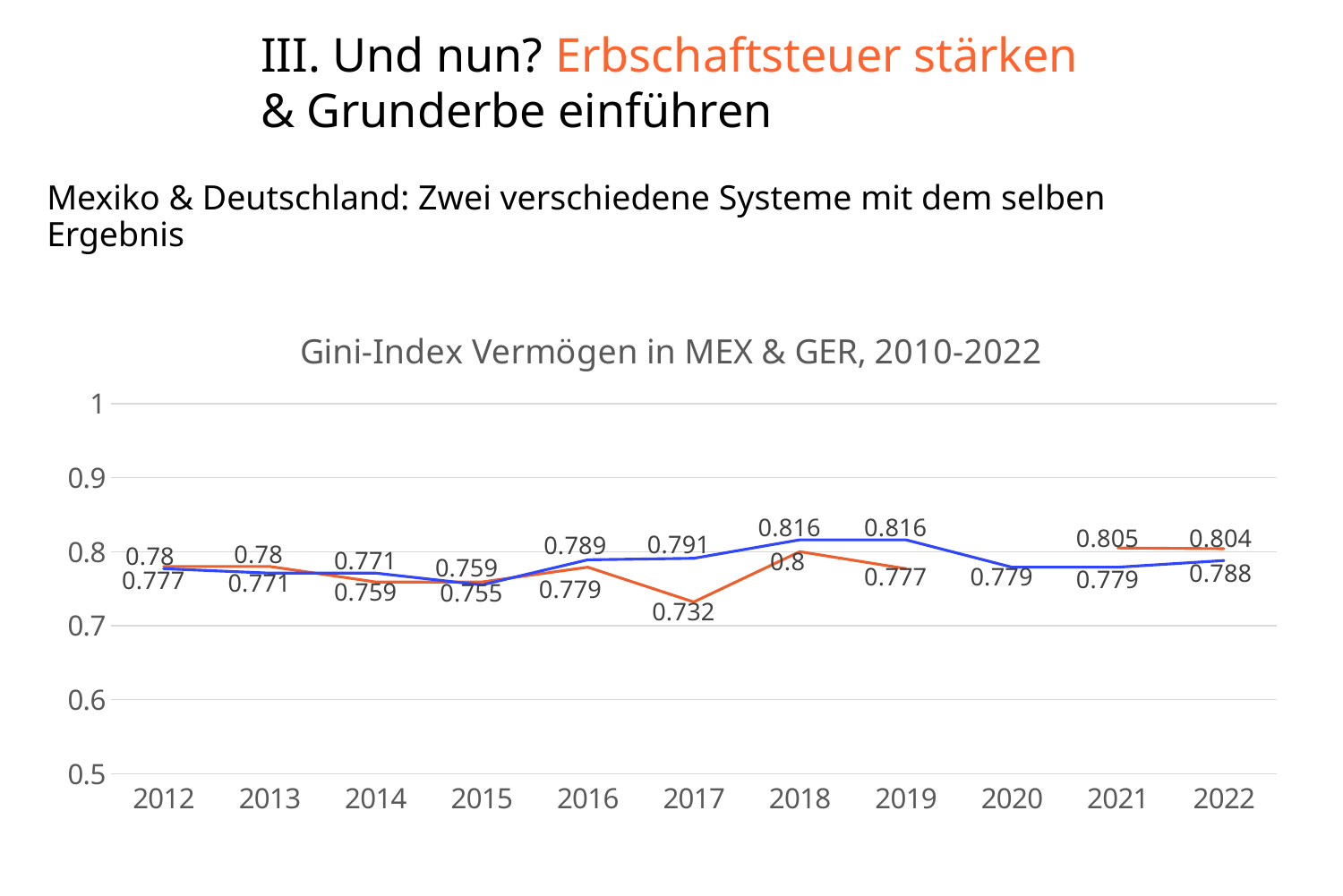
What is the difference between the blue line and the orange line in 2018? 0.016 How many years are shown on the x axis of the chart? 11 What is the value of the orange line in 2017? 0.732 In which year does the blue line reach its lowest value? 2015 What is the value of the blue line in 2018? 0.816 How many lines are plotted in the chart? 2 What is the value of the blue line in 2022? 0.788 What type of chart is shown on the slide? line chart What is the title of the chart? Gini-Index Vermögen in MEX & GER, 2010-2022 In 2017, which line has the higher value, the blue line or the orange line? blue line In which year does the orange line reach its lowest value? 2017 Does the blue line rise or fall from 2015 to 2018? rise